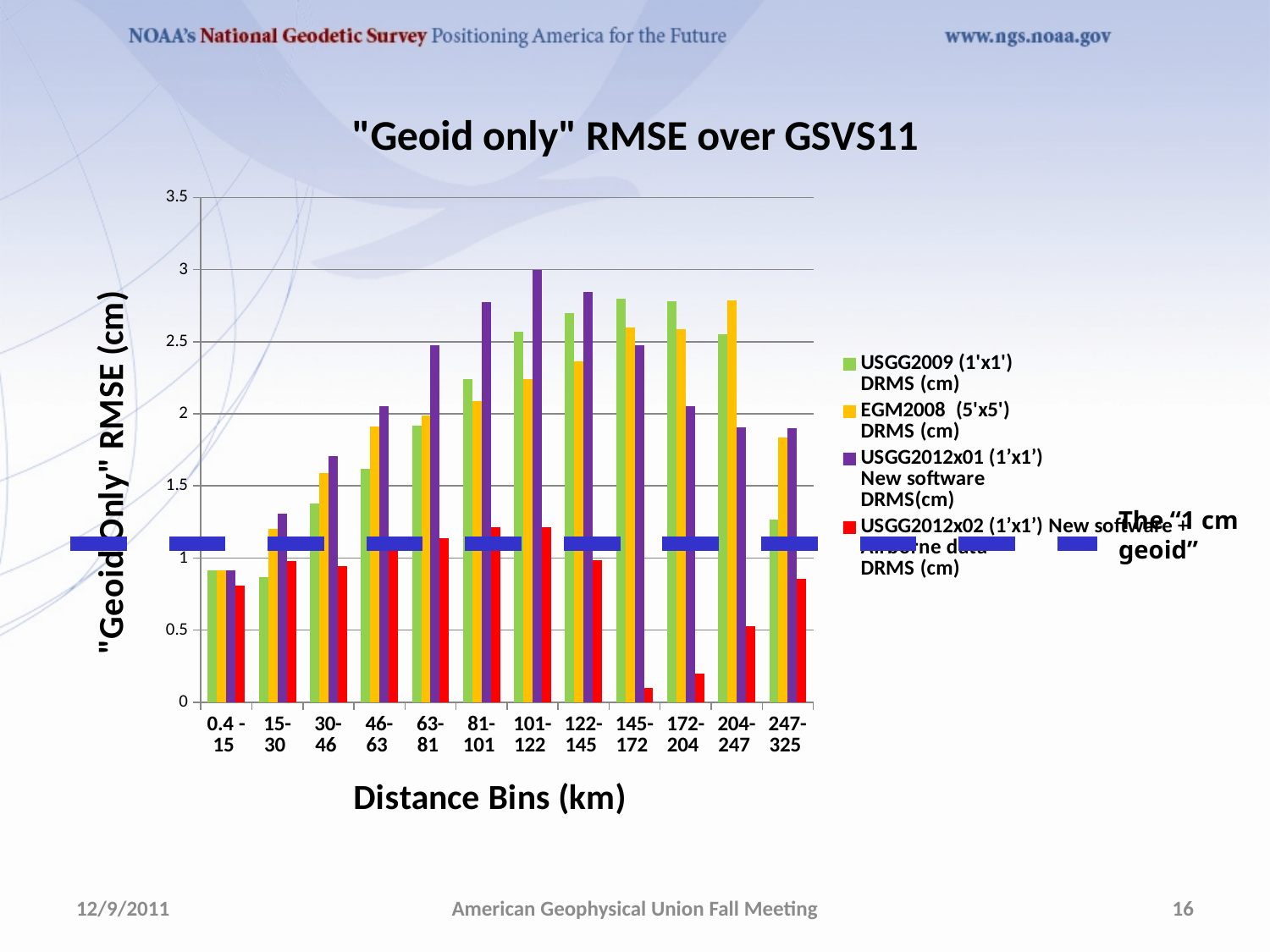
In the 63-81 bin, which is larger: the USGG2009 (1'x1') DRMS value or the USGG2012x01 (1'x1') New software DRMS value? USGG2012x01 (1'x1') New software DRMS Is the USGG2012x02 (1'x1') New software + Airborne data DRMS value for the 145-172 bin greater or less than 0.5? less What is the label of the x axis? Distance Bins (km) Is the EGM2008 (5'x5') DRMS value for the 204-247 bin greater or less than 2.5? greater How many series does the legend list? 4 Which series has the lowest value in the 145-172 bin? USGG2012x02 (1'x1') New software + Airborne data DRMS (cm) What is the title of the chart? "Geoid only" RMSE over GSVS11 How many distance bins are shown along the x axis? 12 Is the USGG2012x02 (1'x1') New software + Airborne data DRMS value for the 172-204 bin greater or less than 0.5? less What kind of chart is shown on the slide? Bar chart In which distance bin does the USGG2012x01 (1'x1') New software DRMS series reach its highest value? 101-122